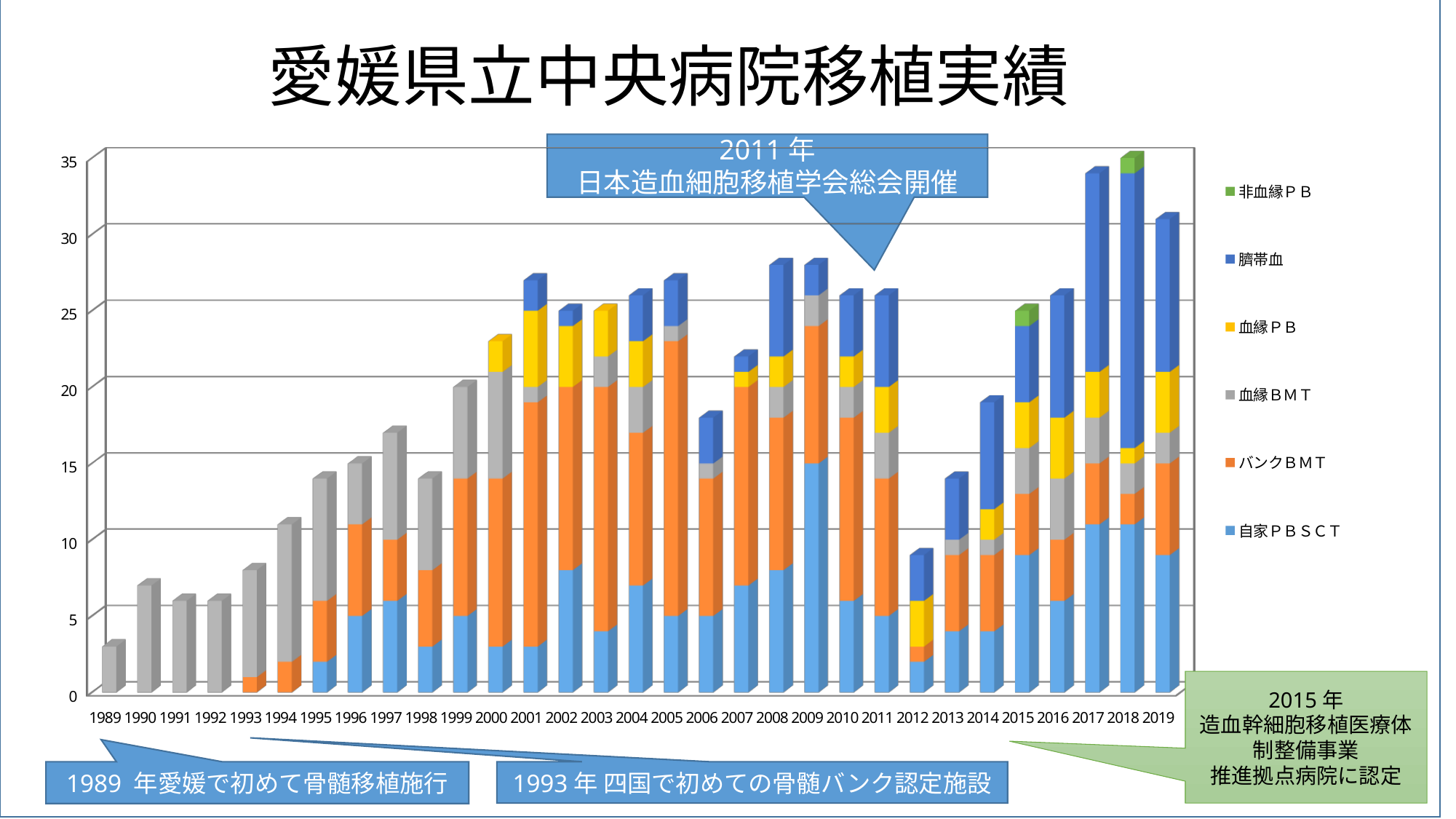
What is the title of the chart on the slide? 愛媛県立中央病院移植実績 Which year has the lowest total bar in the chart? 1989 Is the total for 1989 greater or less than 5? less How many years (categories) are shown along the x axis of the chart? 31 Is the total for 2012 greater or less than 10? less Which year has the highest total bar in the chart? 2018 Which year has a larger total bar, 2019 or 2016? 2019 What kind of chart is shown on the slide? stacked bar chart Which year has a larger total bar, 1990 or 1999? 1999 Which series in the legend is shown in green? 非血縁ＰＢ Is the total for 2017 greater or less than 30? greater How many series does the chart's legend list? 6